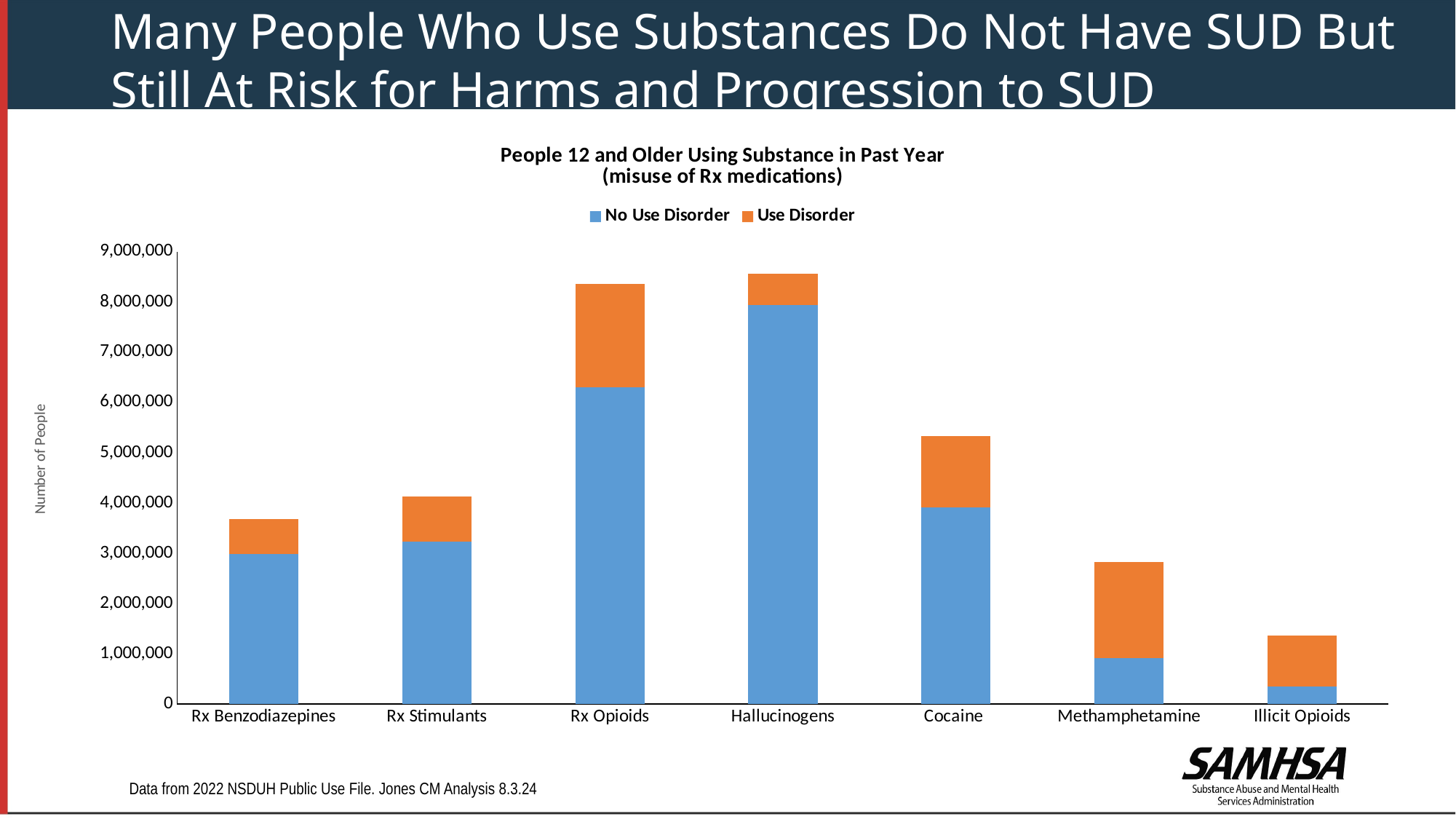
How many substance categories are shown on the x axis? 7 For Methamphetamine, which segment is larger, No Use Disorder or Use Disorder? Use Disorder Which has a larger total bar, Cocaine or Rx Stimulants? Cocaine Is the No Use Disorder value for Rx Opioids greater or less than 6,000,000? greater Is the total bar for Methamphetamine greater or less than 3,000,000? less What kind of chart is shown on the slide? Stacked bar chart Is the No Use Disorder value for Illicit Opioids greater or less than 1,000,000? less How many series does the legend list? 2 Which category has the lowest total bar height? Illicit Opioids Which colour represents the Use Disorder series in the legend? Orange Which category has the highest No Use Disorder value? Hallucinogens